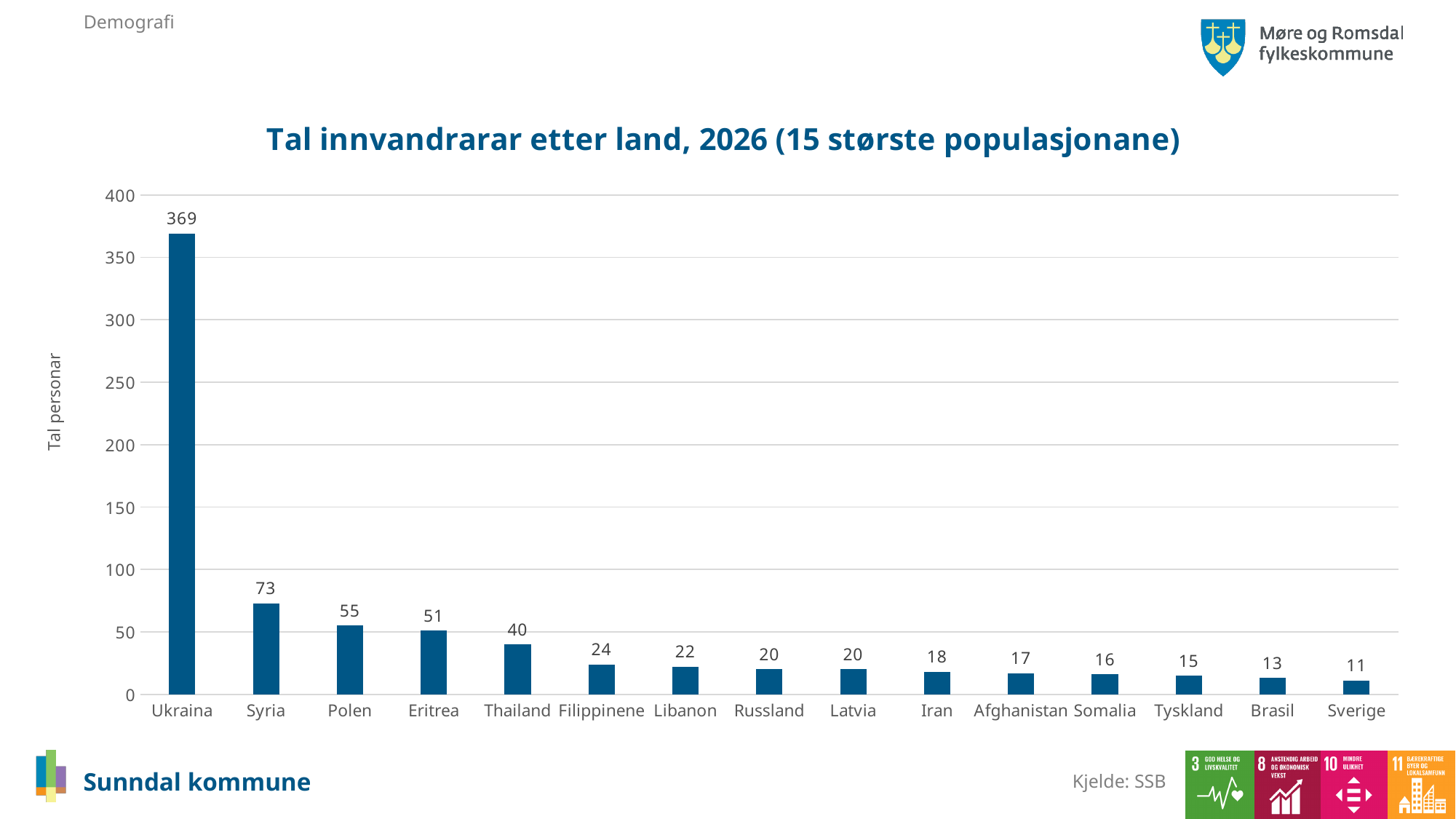
Is the value for Ukraina greater or less than 350? greater Which has a larger value, Thailand or Filippinene? Thailand What kind of chart is this? bar chart Which country has the lowest value? Sverige What is the title of the chart? Tal innvandrarar etter land, 2026 (15 største populasjonane) Do the values rise or fall from left to right along the x axis? fall How many countries are shown on the chart? 15 Which country has the highest value? Ukraina What is the value for Afghanistan? 17 What is the difference between the values for Syria and Polen? 18 What is the value for Eritrea? 51 What is the value for Ukraina? 369